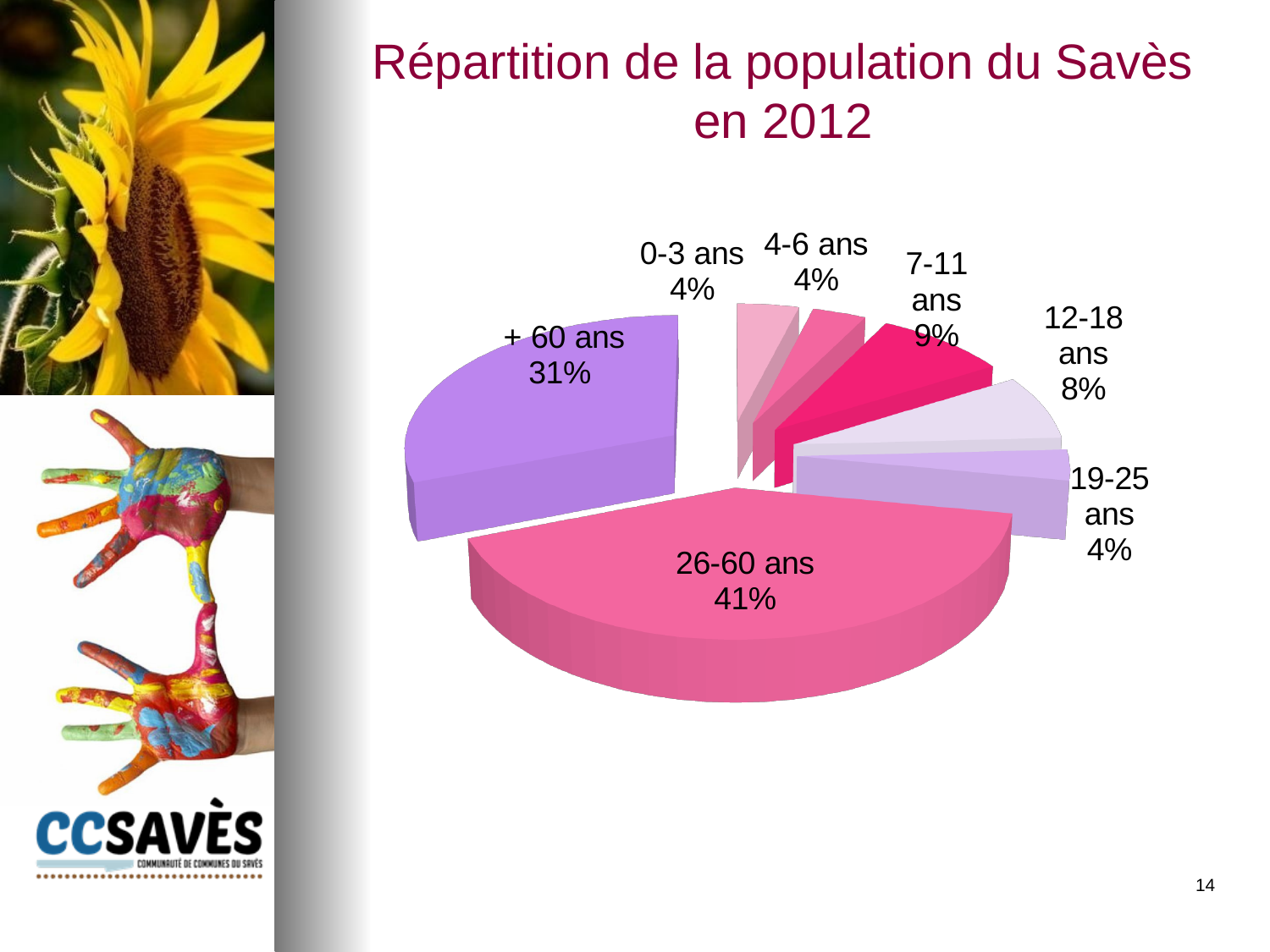
What share of the population is aged 26-60 ans? 41% What share of the population is aged + 60 ans? 31% How many age groups are shown in the pie chart? 7 Which is larger, the share for 7-11 ans or the share for 12-18 ans? 7-11 ans Which age group has the largest share of the population? 26-60 ans What is the difference in percentage points between the 26-60 ans and + 60 ans shares? 10 What share of the population is aged 12-18 ans? 8% What is the combined share of the 0-3 ans and 4-6 ans groups? 8% What share of the population is aged 19-25 ans? 4% What is the title of the chart? Répartition de la population du Savès en 2012 What kind of chart is shown on the slide? pie chart What share of the population is aged 7-11 ans? 9%